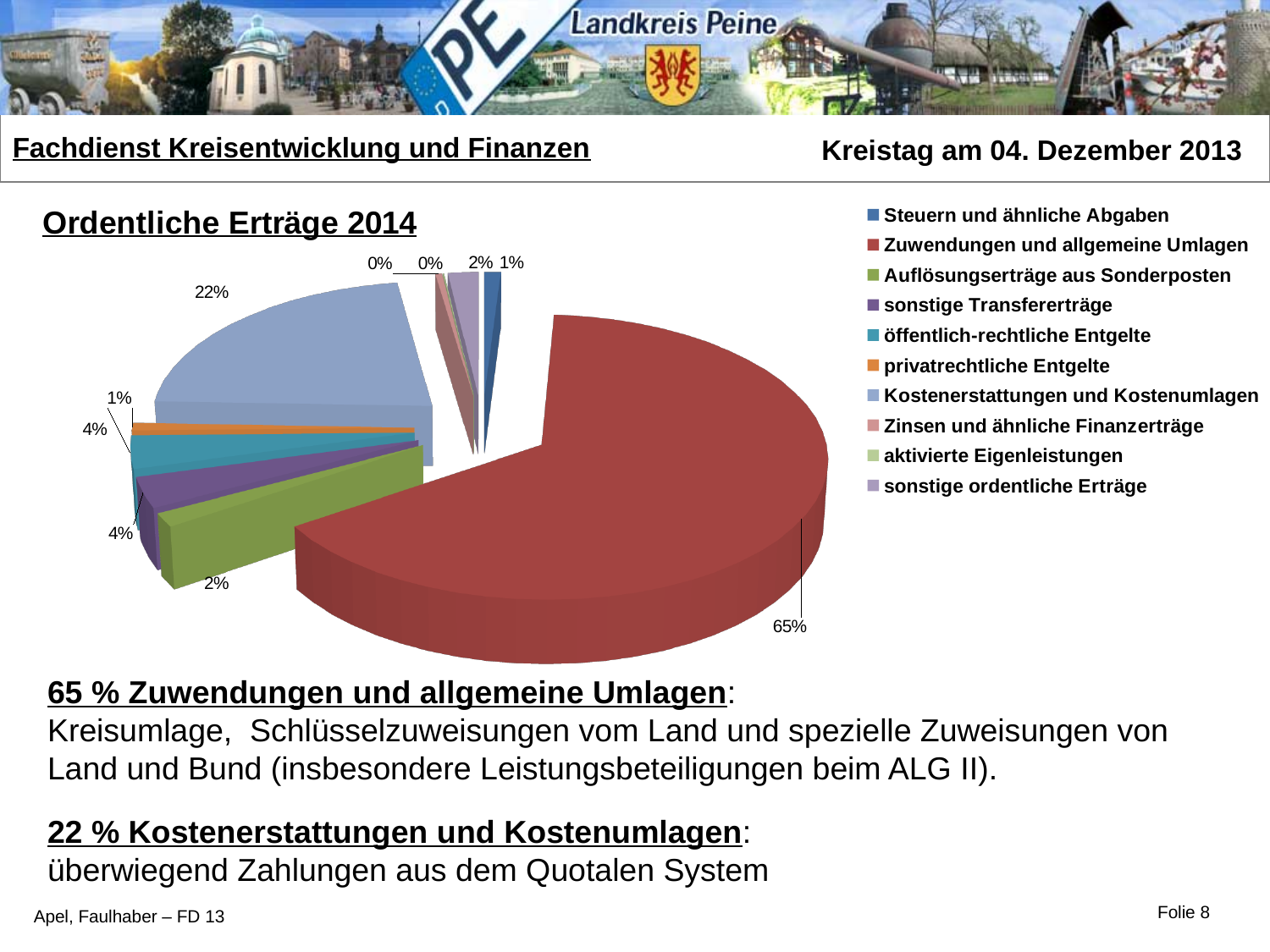
Which category is the second largest slice of the pie? Kostenerstattungen und Kostenumlagen What share of the pie does 'Zuwendungen und allgemeine Umlagen' have? 65% What colour is the largest slice of the pie? red What share of the pie does 'Kostenerstattungen und Kostenumlagen' have? 22% What type of chart is shown on the slide? pie chart How many categories does the legend of the pie chart list? 10 Which category has the largest slice of the pie? Zuwendungen und allgemeine Umlagen What share of the pie does 'Steuern und ähnliche Abgaben' have? 1% What is the title of the chart? Ordentliche Erträge 2014 What is the difference in percentage points between 'Zuwendungen und allgemeine Umlagen' and 'Kostenerstattungen und Kostenumlagen'? 43 percentage points Which is larger: the slice for 'Kostenerstattungen und Kostenumlagen' or the slice for 'Auflösungserträge aus Sonderposten'? Kostenerstattungen und Kostenumlagen